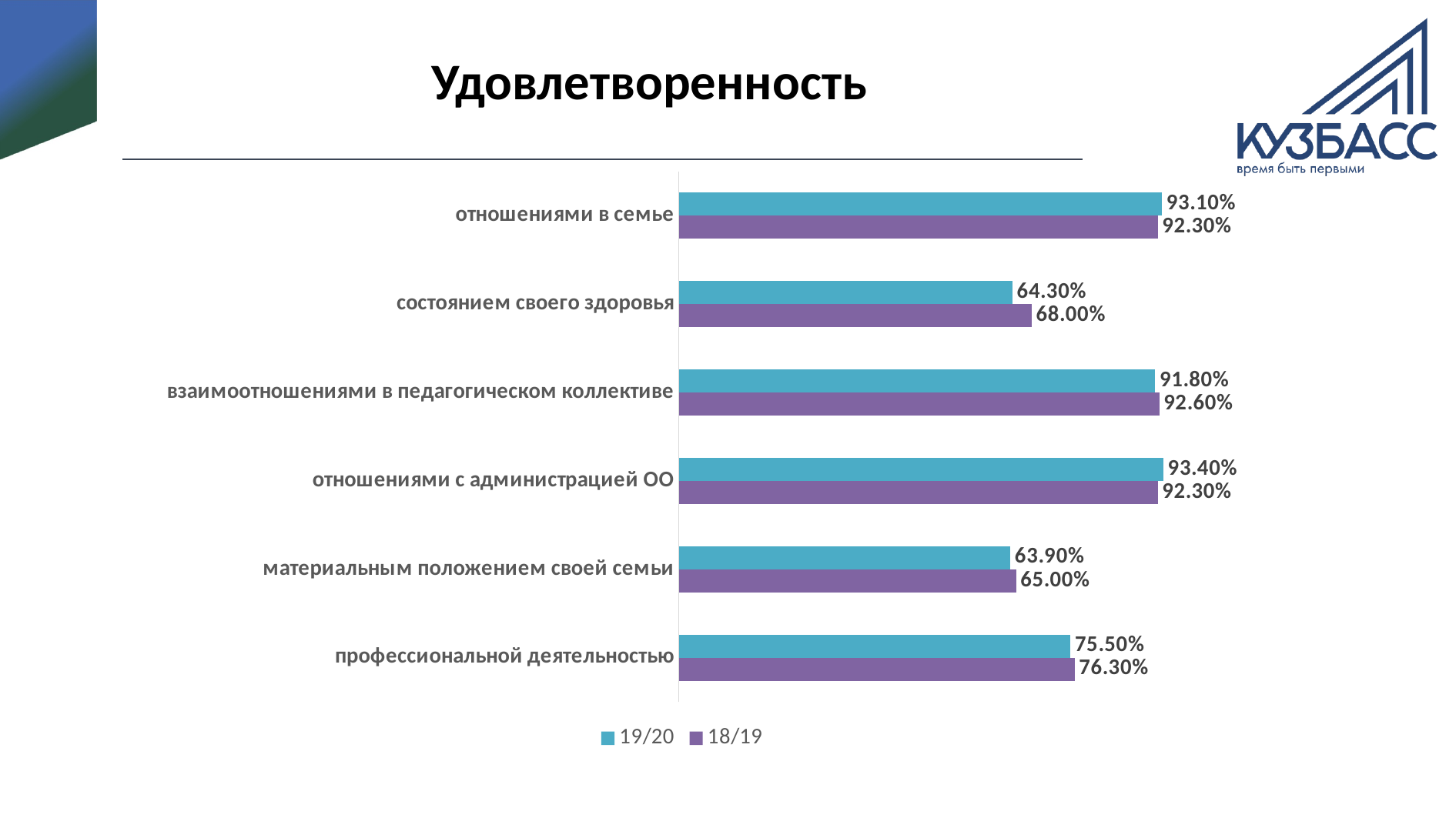
What is the title of the slide? Удовлетворенность What is the difference between the 18/19 and 19/20 values for «состоянием своего здоровья»? 3.70% How many categories are shown in the chart? 6 What is the 19/20 value for «материальным положением своей семьи»? 63.90% Which category has the lowest 18/19 value? материальным положением своей семьи What is the 18/19 value for «профессиональной деятельностью»? 76.30% What is the 18/19 value for «состоянием своего здоровья»? 68.00% What is the 19/20 value for «отношениями в семье»? 93.10% How many series does the legend list? 2 What kind of chart is shown on the slide? bar chart Which category has the highest 19/20 value? отношениями с администрацией ОО For «взаимоотношениями в педагогическом коллективе», which series has the larger value, 19/20 or 18/19? 18/19